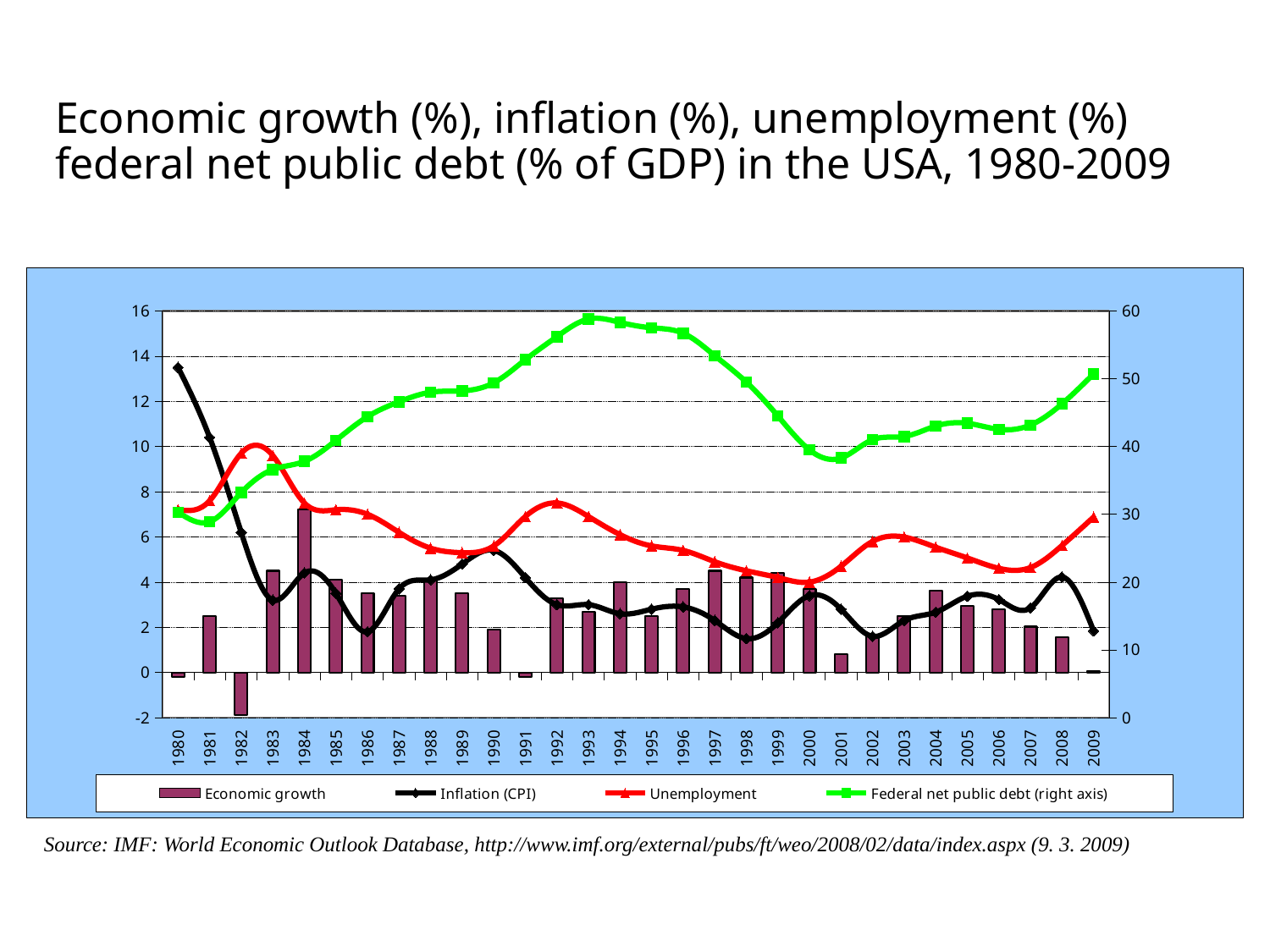
How many series does the legend list? 4 Is the value for Federal net public debt in 2001 greater or less than 40? less In which year is Economic growth highest? 1984 In which year is Federal net public debt highest? 1993 Which is larger, Economic growth in 1984 or in 1985? 1984 In which year is Economic growth lowest? 1982 In which year is Inflation (CPI) highest? 1980 Is the value for Inflation (CPI) in 1980 greater or less than 12? greater How many years are shown on the x axis? 30 Which series is plotted against the right axis? Federal net public debt Does Inflation (CPI) rise or fall from 1980 to 1983? fall What kind of chart is this? Combined bar and line chart